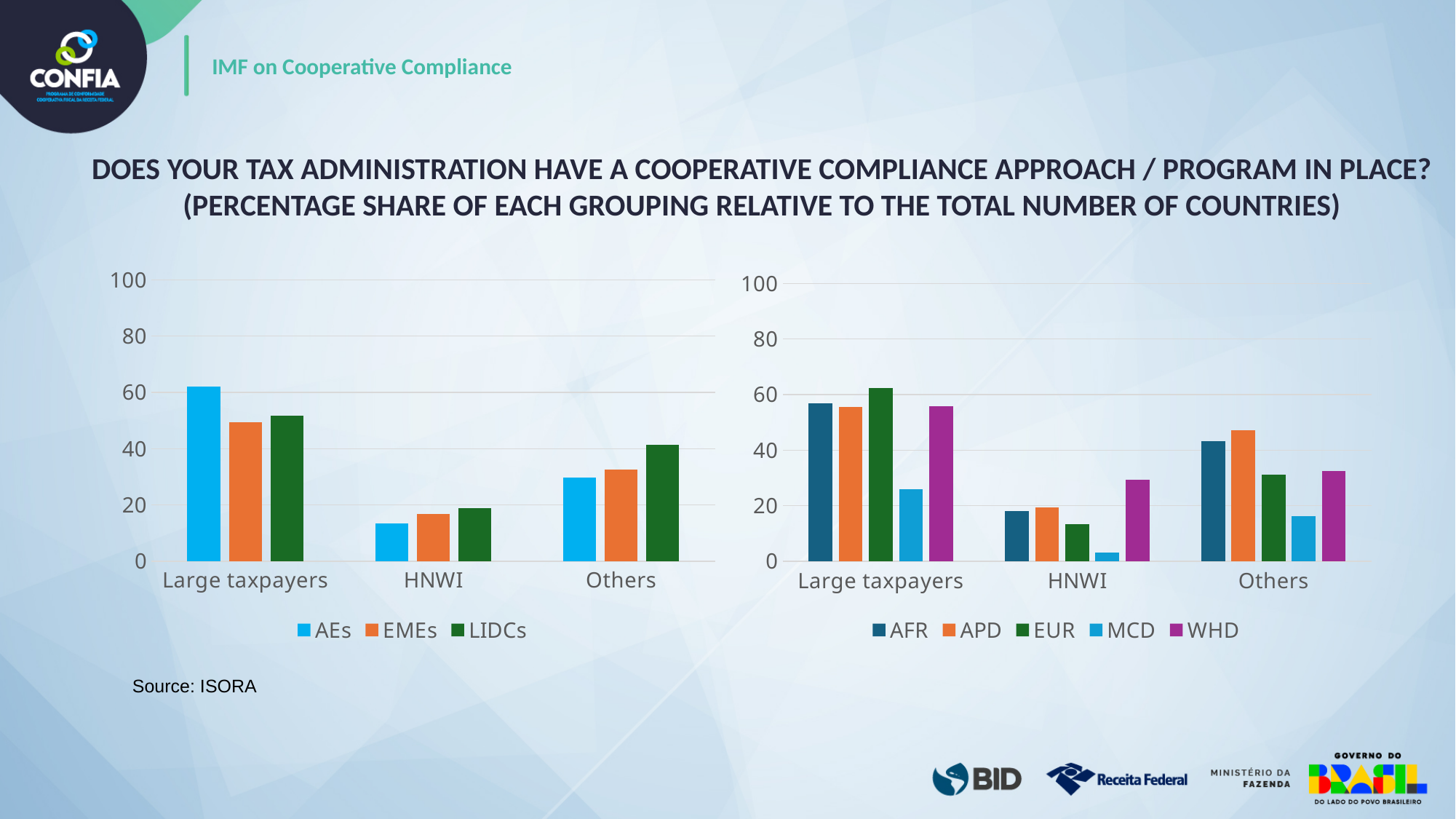
In the right chart, is the value of MCD for Large taxpayers greater or less than 40? less What kind of chart is the left chart (with AEs, EMEs and LIDCs)? bar chart How many categories are shown on the x axis of the left chart? 3 How many series does the legend of the left chart list? 3 In the right chart, which is larger for Others: APD or EUR? APD In the left chart, which series has the highest value for Large taxpayers? AEs In the left chart, is the value of AEs for Large taxpayers greater or less than 60? greater How many series does the legend of the right chart list? 5 Which series in the right chart is shown in purple? WHD In the right chart, which series has the highest value for HNWI? WHD In the left chart, which series has the lowest value for HNWI? AEs In the right chart, which series has the lowest value for HNWI? MCD